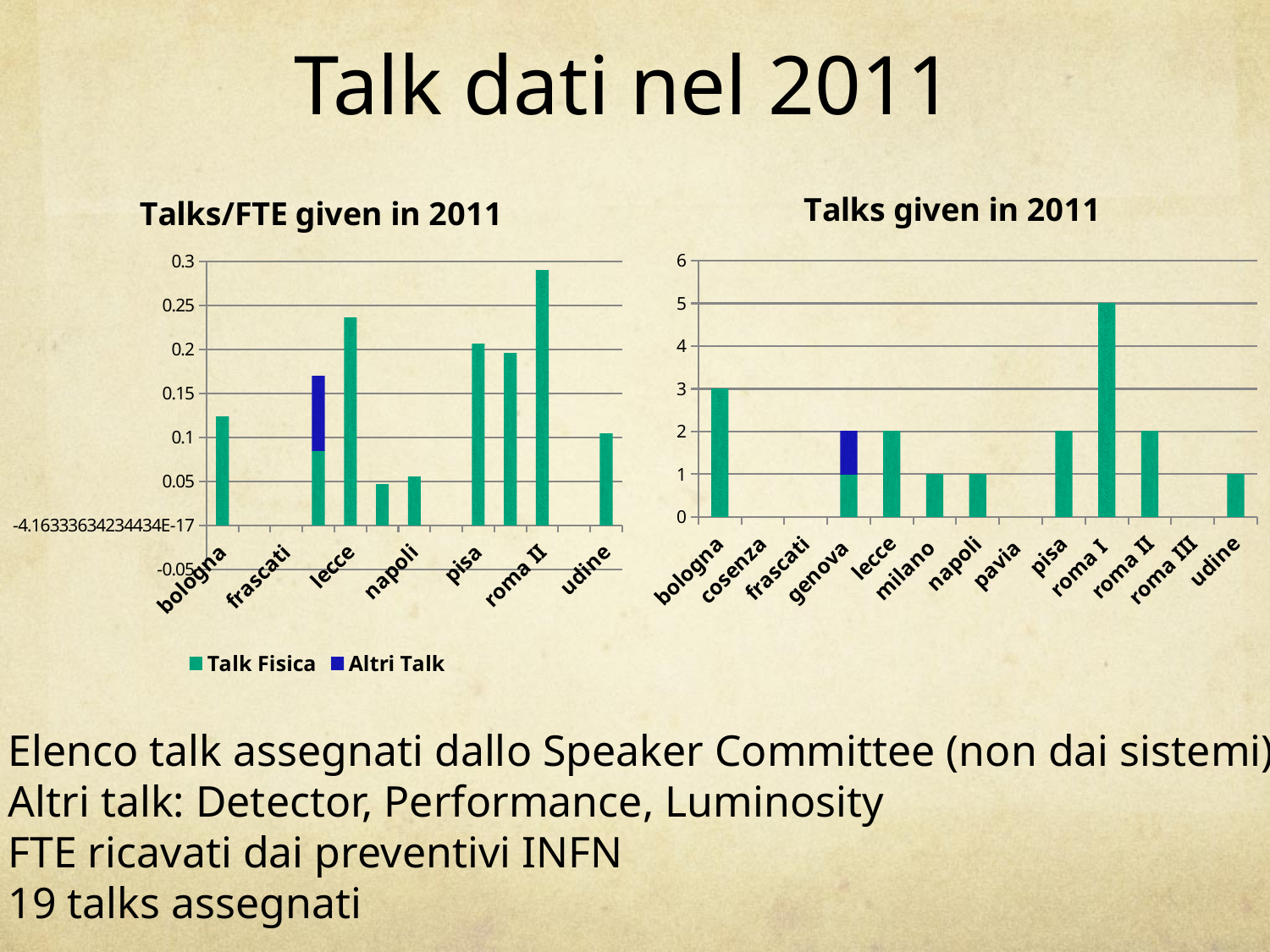
In the 'Talks given in 2011' chart, how many categories are shown on the x axis? 13 In the 'Talks given in 2011' chart, which category has the highest bar? roma I In the 'Talks given in 2011' chart, how many talks were given by roma I? 5 How many series does the legend of the 'Talks/FTE given in 2011' chart list? 2 In the 'Talks given in 2011' chart, what is the difference between the values for roma I and bologna? 2 What are the two legend entries shown under the 'Talks/FTE given in 2011' chart? Talk Fisica and Altri Talk What kind of chart is the 'Talks/FTE given in 2011' chart? bar chart In the 'Talks given in 2011' chart, what is the total height of the stacked bar for genova? 2 In the 'Talks/FTE given in 2011' chart, is the value for roma II greater or less than 0.25? greater In the 'Talks given in 2011' chart, how many talks were given by bologna? 3 In the 'Talks given in 2011' chart, which is larger, the value for lecce or the value for milano? lecce In the 'Talks/FTE given in 2011' chart, is the value for napoli greater or less than 0.1? less